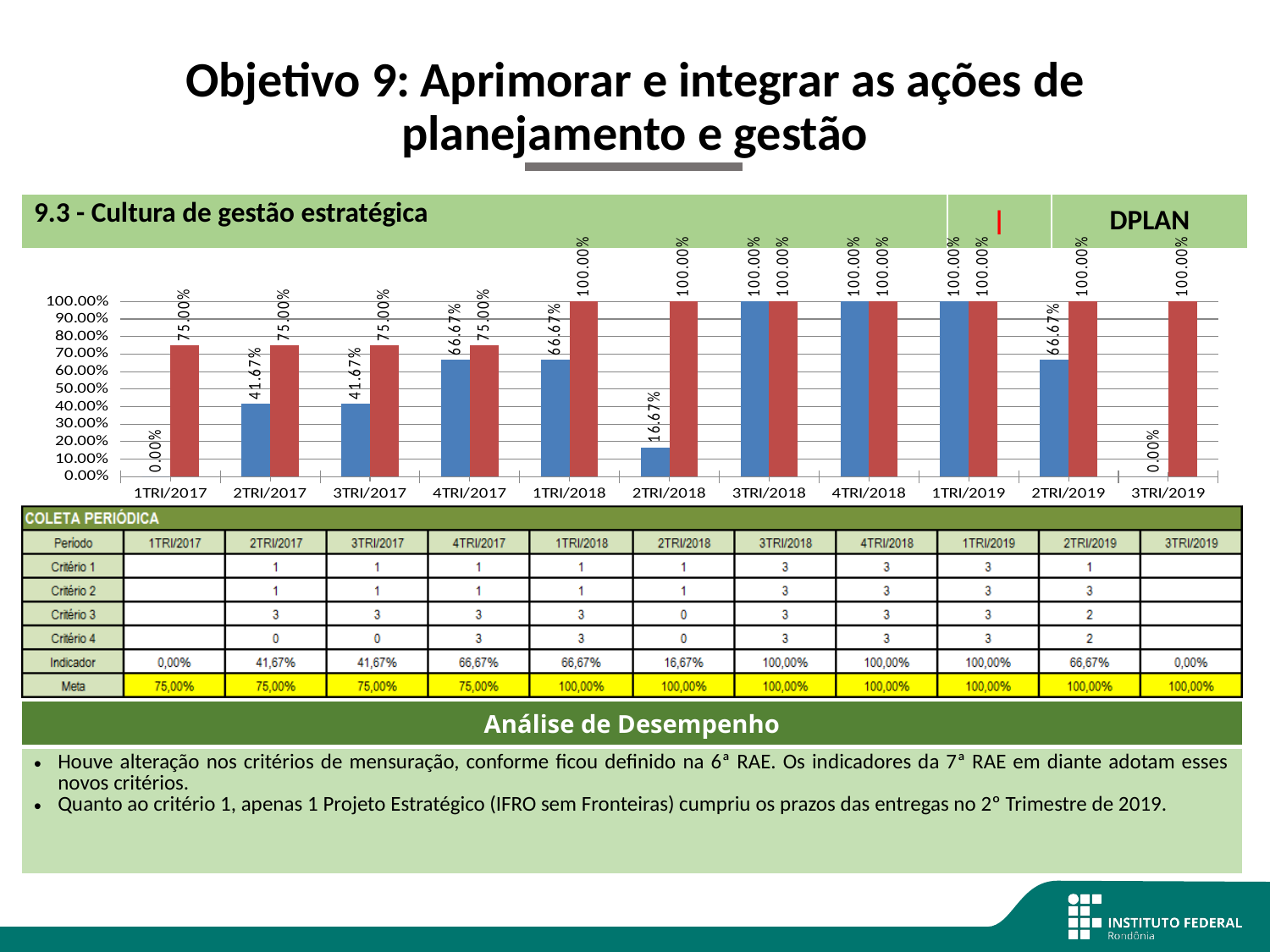
What is the difference between the red bar and the blue bar for 2TRI/2018? 83.33% What is the value of the red bar (Meta) for 1TRI/2018? 100.00% What is the value of the red bar (Meta) for 3TRI/2017? 75.00% What is the title shown above the chart? 9.3 - Cultura de gestão estratégica What is the value of the blue bar (Indicador) for 4TRI/2017? 66.67% What is the value of the blue bar (Indicador) for 2TRI/2018? 16.67% What is the difference between the red bar and the blue bar for 2TRI/2017? 33.33% What kind of chart is shown on the slide? Bar chart What is the value of the blue bar (Indicador) for 3TRI/2019? 0.00% Which is larger, the blue bar for 2TRI/2017 or the blue bar for 4TRI/2017? 4TRI/2017 How many periods are shown on the x axis of the chart? 11 Do the red bars (Meta) rise or fall from 1TRI/2017 to 3TRI/2019? Rise